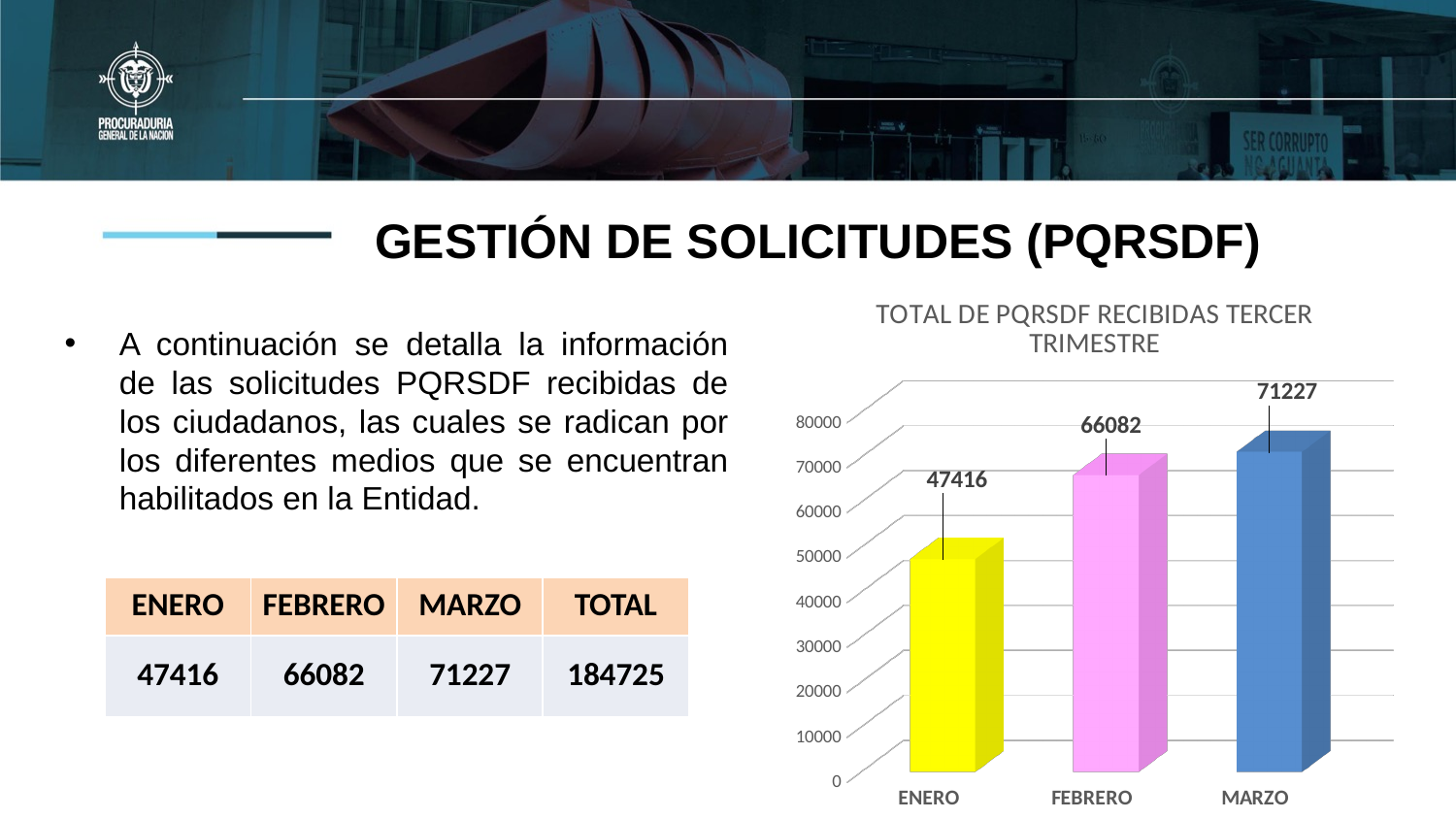
Which month has the highest value in the chart? MARZO What is the difference between the values for MARZO and ENERO? 23811 Is the value for ENERO greater or less than 50000? less What kind of chart is shown on the slide? bar chart Which is larger, the value for FEBRERO or the value for MARZO? MARZO Which month has the lowest value in the chart? ENERO Do the values rise or fall from ENERO to MARZO? rise What is the value for MARZO in the chart? 71227 What is the value for ENERO in the chart? 47416 What is the difference between the values for FEBRERO and ENERO? 18666 What is the value for FEBRERO in the chart? 66082 How many months are shown in the chart? 3